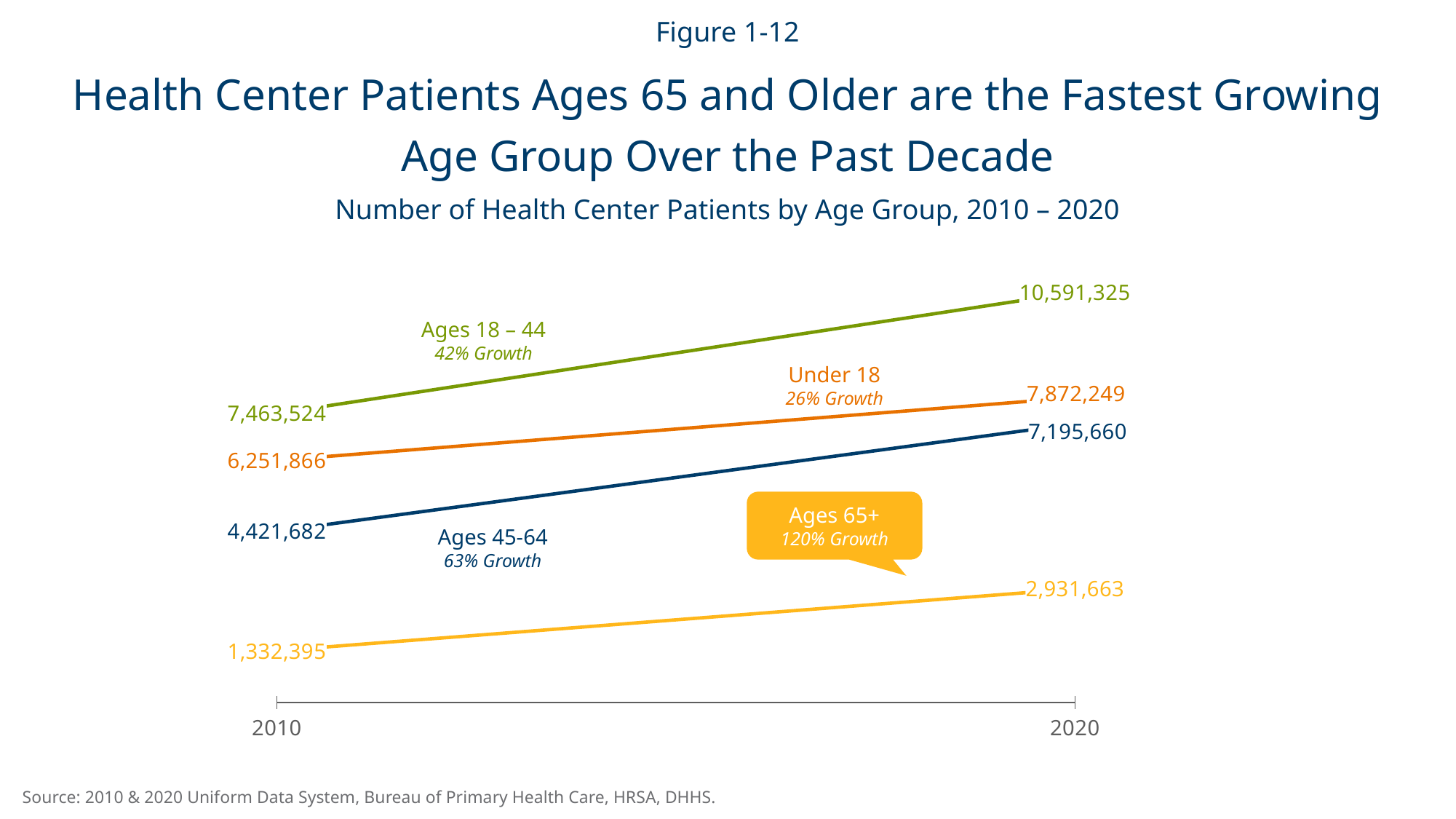
What was the number of health center patients under 18 in 2010? 6,251,866 In 2020, which was larger: the number of patients under 18 or the number of patients ages 45-64? Under 18 What growth percentage is shown for the Ages 65+ group? 120% Growth Which age group had the highest number of patients in 2020? Ages 18 – 44 How many age groups (series) are plotted on the chart? 4 What was the number of health center patients ages 65+ in 2020? 2,931,663 What was the number of health center patients ages 45-64 in 2010? 4,421,682 By how much did the number of patients ages 45-64 increase from 2010 to 2020? 2,773,978 Does the number of patients ages 18–44 rise or fall from 2010 to 2020? Rise What kind of chart is shown on the slide? Line chart Which age group had the lowest number of patients in 2010? Ages 65+ What was the number of health center patients ages 18–44 in 2020? 10,591,325